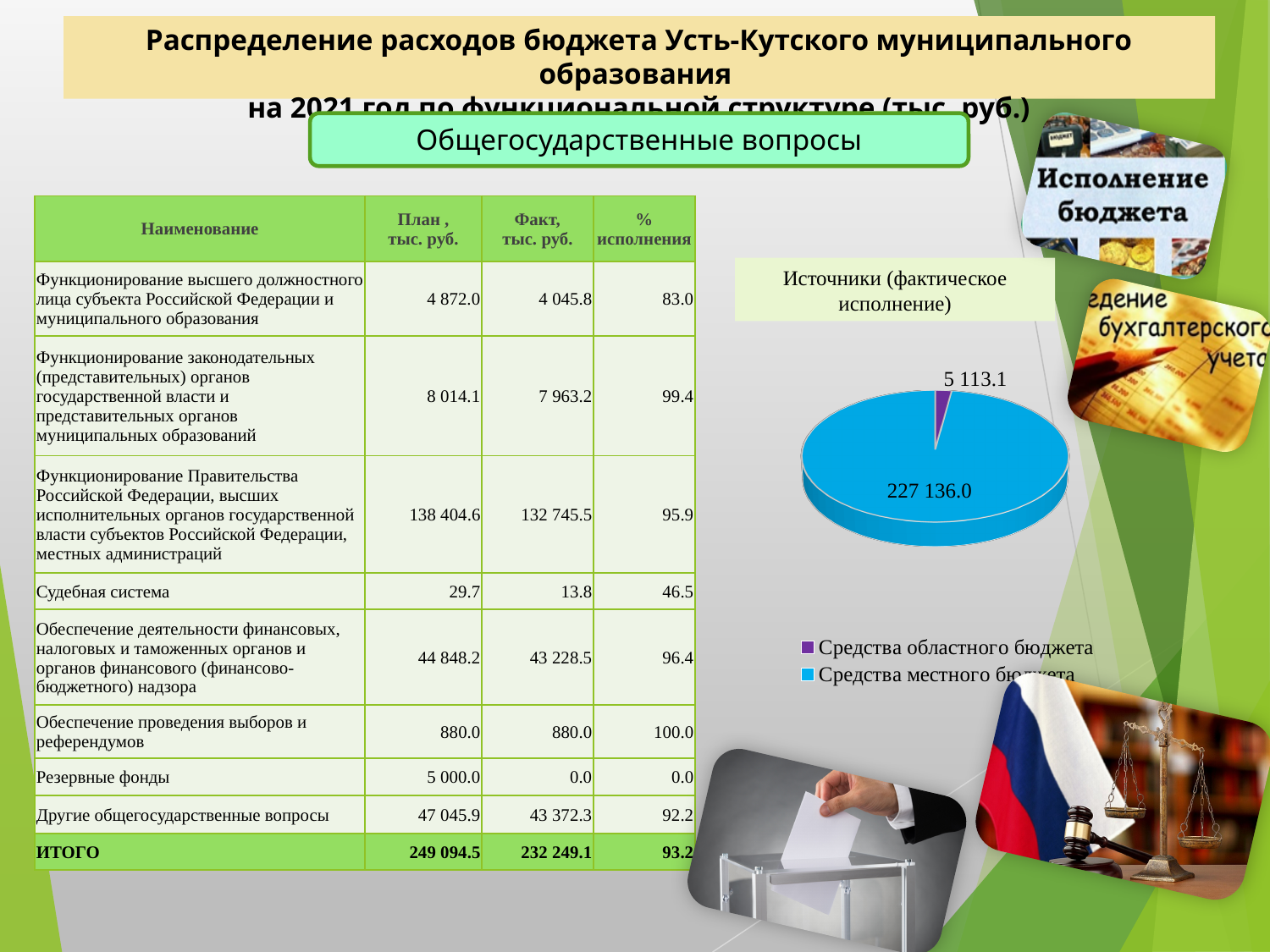
In the pie chart "Источники (фактическое исполнение)", which source has the smallest slice? Средства областного бюджета In the pie chart "Источники (фактическое исполнение)", what value is shown for the larger slice (Средства местного бюджета)? 227 136.0 In the pie chart "Источники (фактическое исполнение)", which source has the largest slice? Средства местного бюджета What is the title of the pie chart on the slide? Источники (фактическое исполнение) What kind of chart is shown under the heading "Источники (фактическое исполнение)"? Pie chart In the pie chart "Источники (фактическое исполнение)", what is the difference between the value for Средства местного бюджета and the value for Средства областного бюджета? 222 022.9 How many entries does the legend of the pie chart "Источники (фактическое исполнение)" list? 2 In the pie chart "Источники (фактическое исполнение)", what value is shown for the smaller slice (Средства областного бюджета)? 5 113.1 In the pie chart "Источники (фактическое исполнение)", what colour is the slice for Средства областного бюджета? Purple In the pie chart "Источники (фактическое исполнение)", how many slices are there? 2 In the pie chart "Источники (фактическое исполнение)", which is larger: Средства областного бюджета or Средства местного бюджета? Средства местного бюджета In the pie chart "Источники (фактическое исполнение)", what is the total of the two slice values? 232 249.1